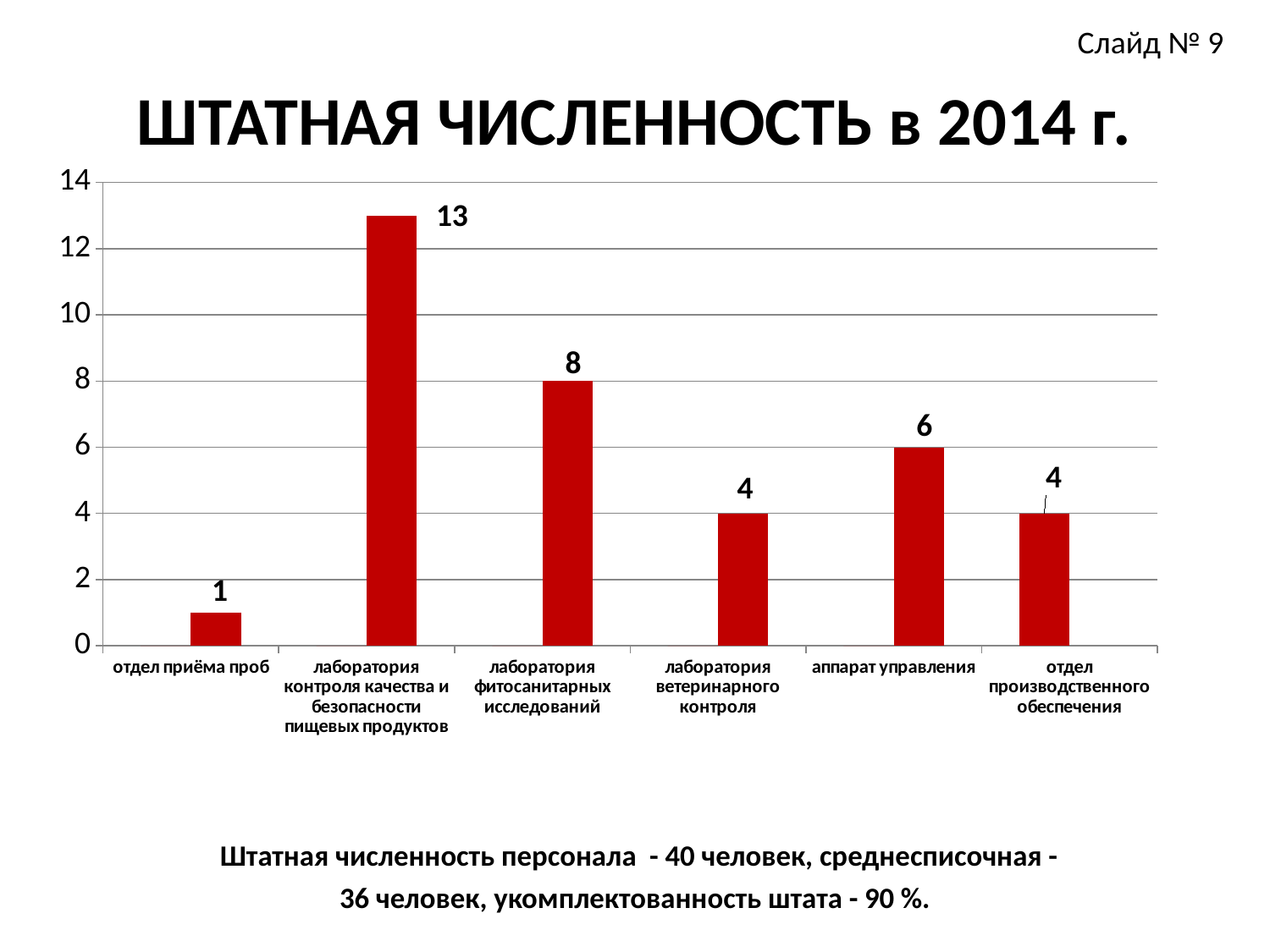
Which category has the lowest value? отдел приёма проб What kind of chart is shown on the slide? bar chart What colour are the bars in the chart? red What is the title of the chart? ШТАТНАЯ ЧИСЛЕННОСТЬ в 2014 г. How many categories are shown on the chart? 6 What is the value for лаборатория контроля качества и безопасности пищевых продуктов? 13 Which is larger: аппарат управления or лаборатория ветеринарного контроля? аппарат управления Which category has the highest value? лаборатория контроля качества и безопасности пищевых продуктов What is the value for аппарат управления? 6 What is the value for отдел приёма проб? 1 Is the value for лаборатория фитосанитарных исследований greater or less than 10? less What is the difference between лаборатория контроля качества и безопасности пищевых продуктов and лаборатория фитосанитарных исследований? 5